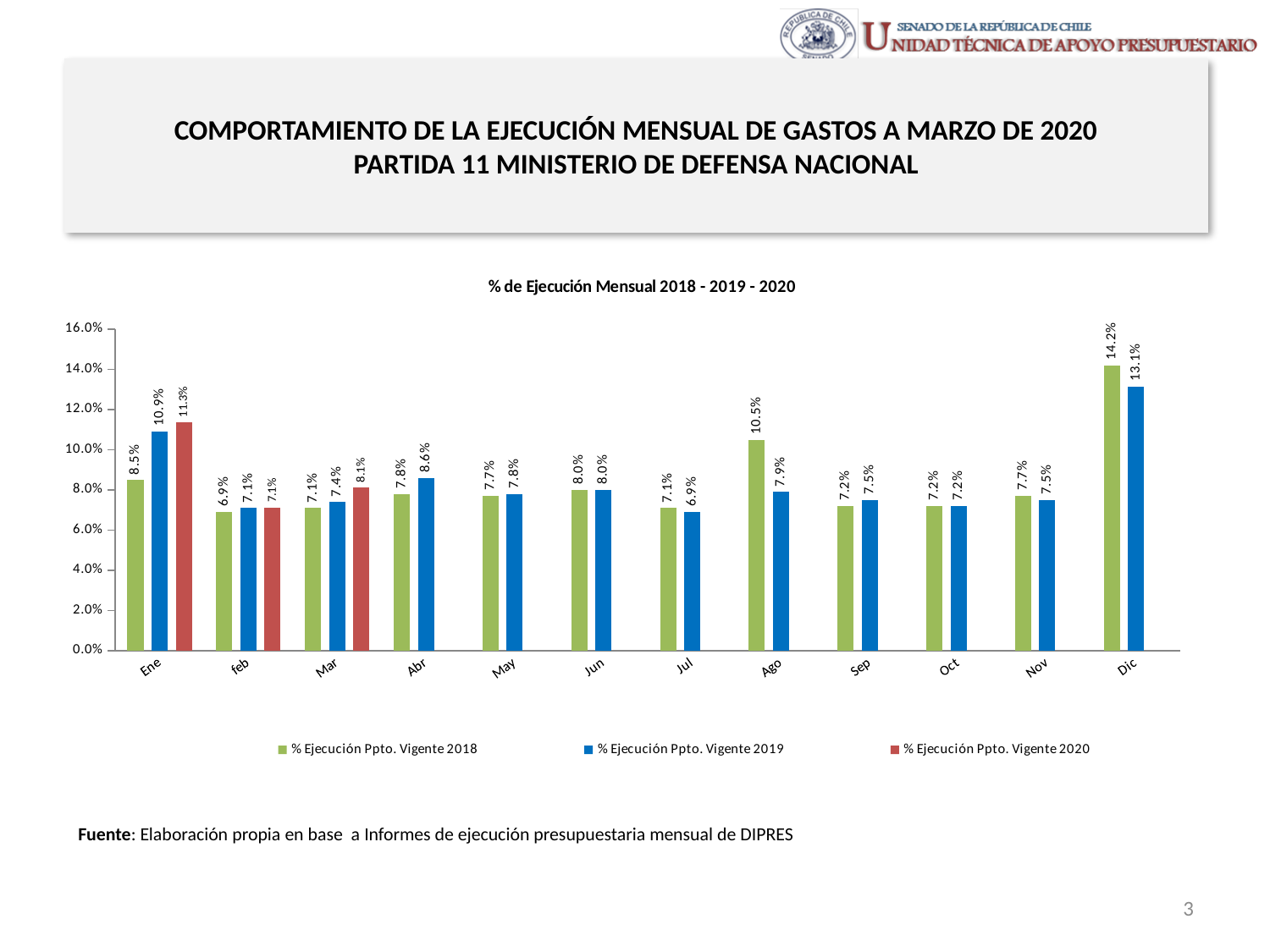
What kind of chart is shown on the slide? Bar chart What is the difference between the 2020 and 2018 values for Ene? 2.8% How many series does the legend list? 3 How many months are shown on the x axis? 12 What is the title of the chart? % de Ejecución Mensual 2018 - 2019 - 2020 Which month has the highest value for % Ejecución Ppto. Vigente 2018? Dic Is the value of % Ejecución Ppto. Vigente 2019 for Ene greater or less than 10.0%? greater What is the value of % Ejecución Ppto. Vigente 2019 for Dic? 13.1% Which is larger for Abr: the 2018 value or the 2019 value? 2019 value (8.6%) What is the value of % Ejecución Ppto. Vigente 2018 for Ago? 10.5% Which month has the lowest value for % Ejecución Ppto. Vigente 2018? feb What is the value of % Ejecución Ppto. Vigente 2020 for Mar? 8.1%